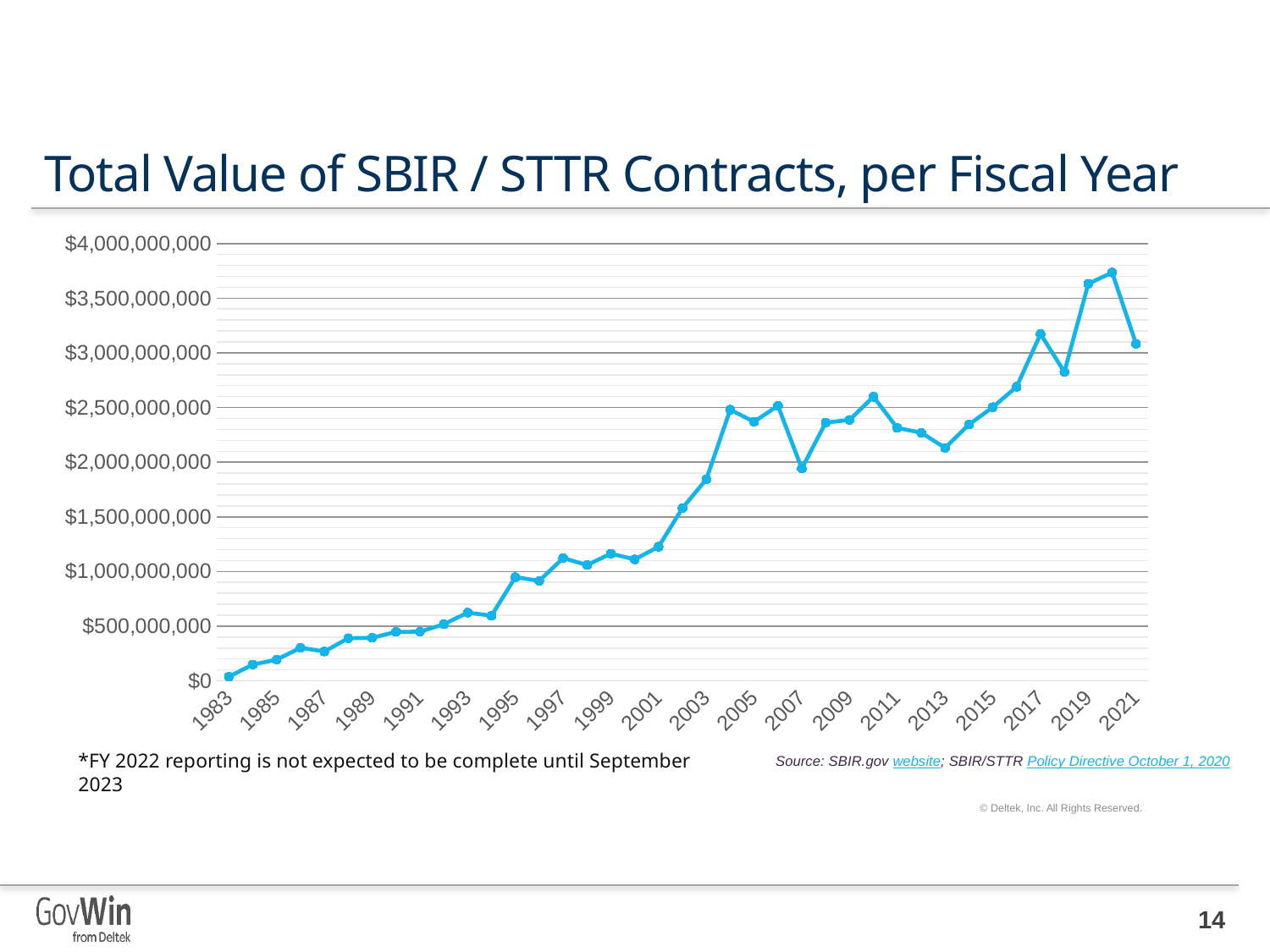
What is the title of the chart? Total Value of SBIR / STTR Contracts, per Fiscal Year Is the value for 2003 greater or less than $1,500,000,000? greater Which year has the larger value, 2019 or 2021? 2019 Overall, do the values rise or fall from 1983 to 2021? rise Which year has the larger value, 2005 or 2007? 2005 Which fiscal year has the highest total value? 2020 How many year labels are shown on the x axis? 20 Which fiscal year has the lowest total value? 1983 Is the value for 2017 greater or less than $3,000,000,000? greater What kind of chart is shown on the slide? line chart Is the value for 2018 greater or less than $3,000,000,000? less